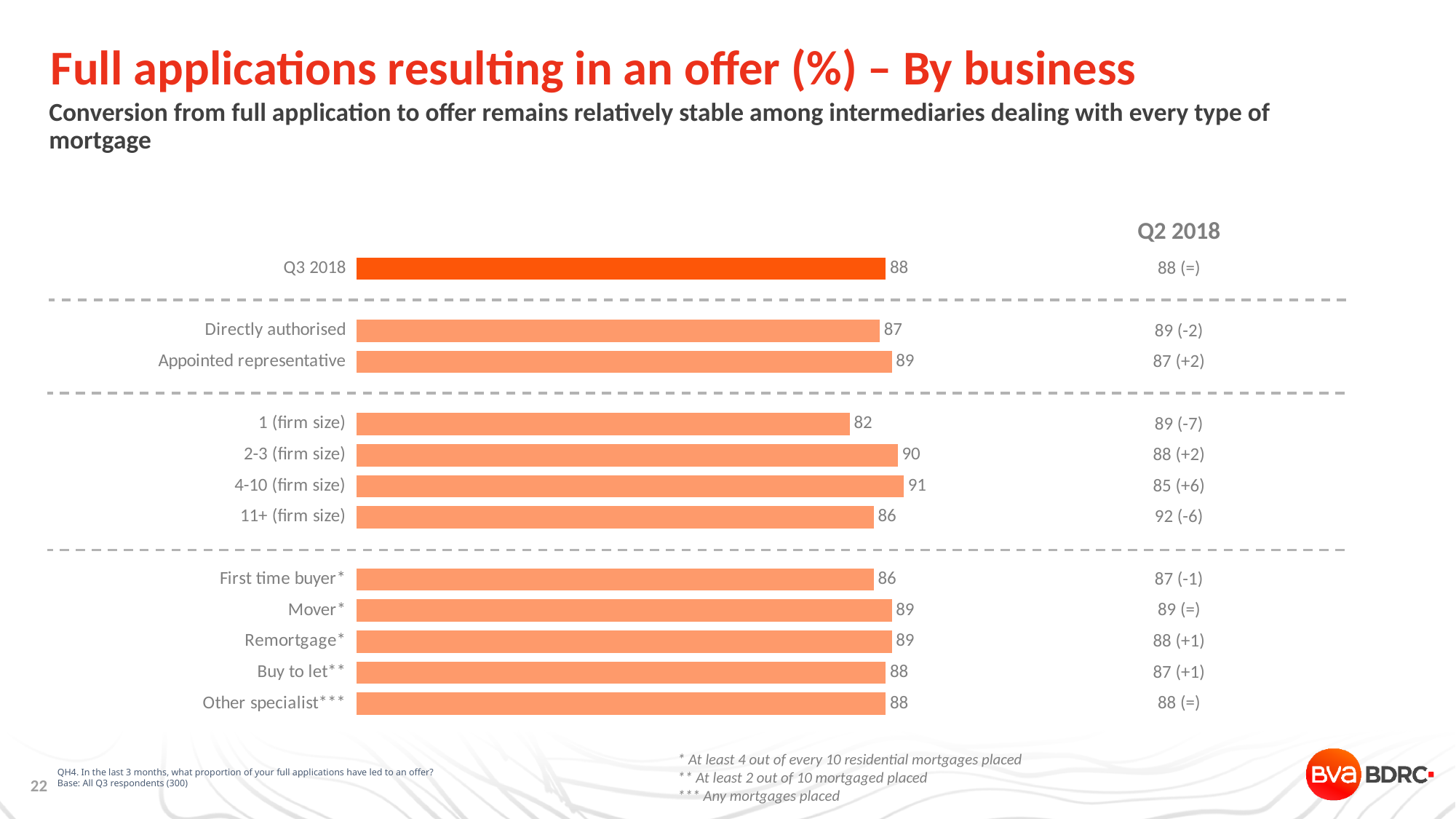
Which category has the lowest value? 1 (firm size) What is the value for 1 (firm size)? 82 What kind of chart is shown on the slide? Bar chart What Q2 2018 value is shown for 11+ (firm size)? 92 (-6) What is the value for Buy to let? 88 Which category has the highest value? 4-10 (firm size) What is the value for Q3 2018 overall? 88 What is the value for Appointed representative? 89 What is the difference between the values for Appointed representative and Directly authorised? 2 Which is larger, the value for 2-3 (firm size) or the value for 11+ (firm size)? 2-3 (firm size) What is the difference between the values for 4-10 (firm size) and 1 (firm size)? 9 How many bars are plotted on the chart? 13